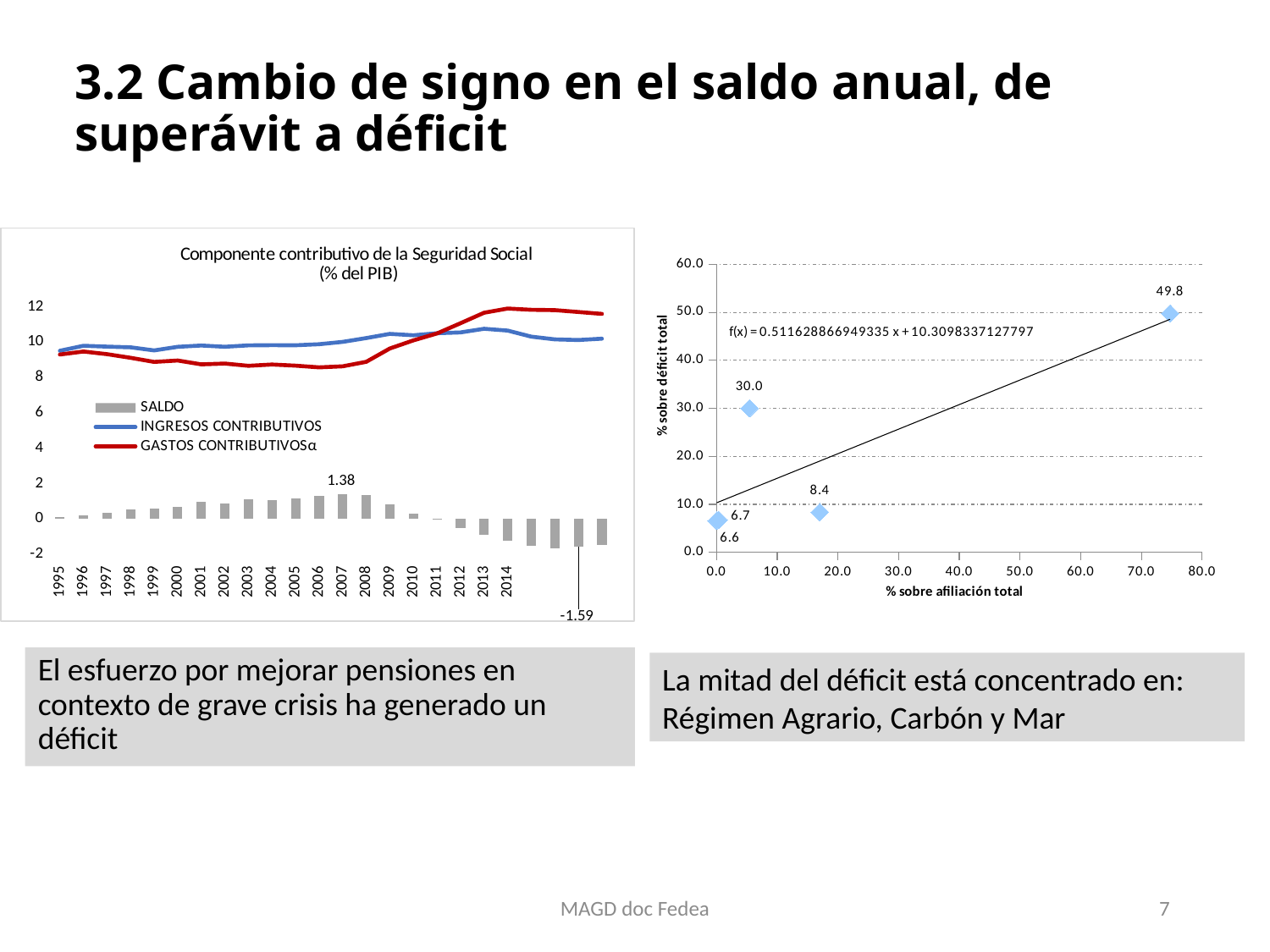
In the right chart (scatter plot), what is the highest '% sobre déficit total' value labelled on a point? 49.8 In the left chart 'Componente contributivo de la Seguridad Social', which line is higher in 2014, INGRESOS CONTRIBUTIVOS or GASTOS CONTRIBUTIVOS? GASTOS CONTRIBUTIVOS In the left chart 'Componente contributivo de la Seguridad Social', does the GASTOS CONTRIBUTIVOS line rise or fall between 2008 and 2013? rise In the right chart (scatter plot), what is the title of the x axis? % sobre afiliación total In the right chart (scatter plot), what is the difference between the points labelled 49.8 and 30.0? 19.8 In the left chart 'Componente contributivo de la Seguridad Social', how many series does the legend list? 3 In the left chart 'Componente contributivo de la Seguridad Social', is the value of GASTOS CONTRIBUTIVOS in 2013 greater or less than 10? greater In the right chart (scatter plot), how many data points are plotted? 5 In the left chart 'Componente contributivo de la Seguridad Social', what is the highest SALDO value labelled on the bars? 1.38 What kind of chart is the right chart on the slide? scatter chart In the left chart 'Componente contributivo de la Seguridad Social', is the value of GASTOS CONTRIBUTIVOS in 2006 greater or less than 10? less In the left chart 'Componente contributivo de la Seguridad Social', what is the lowest SALDO value labelled on the bars? -1.59